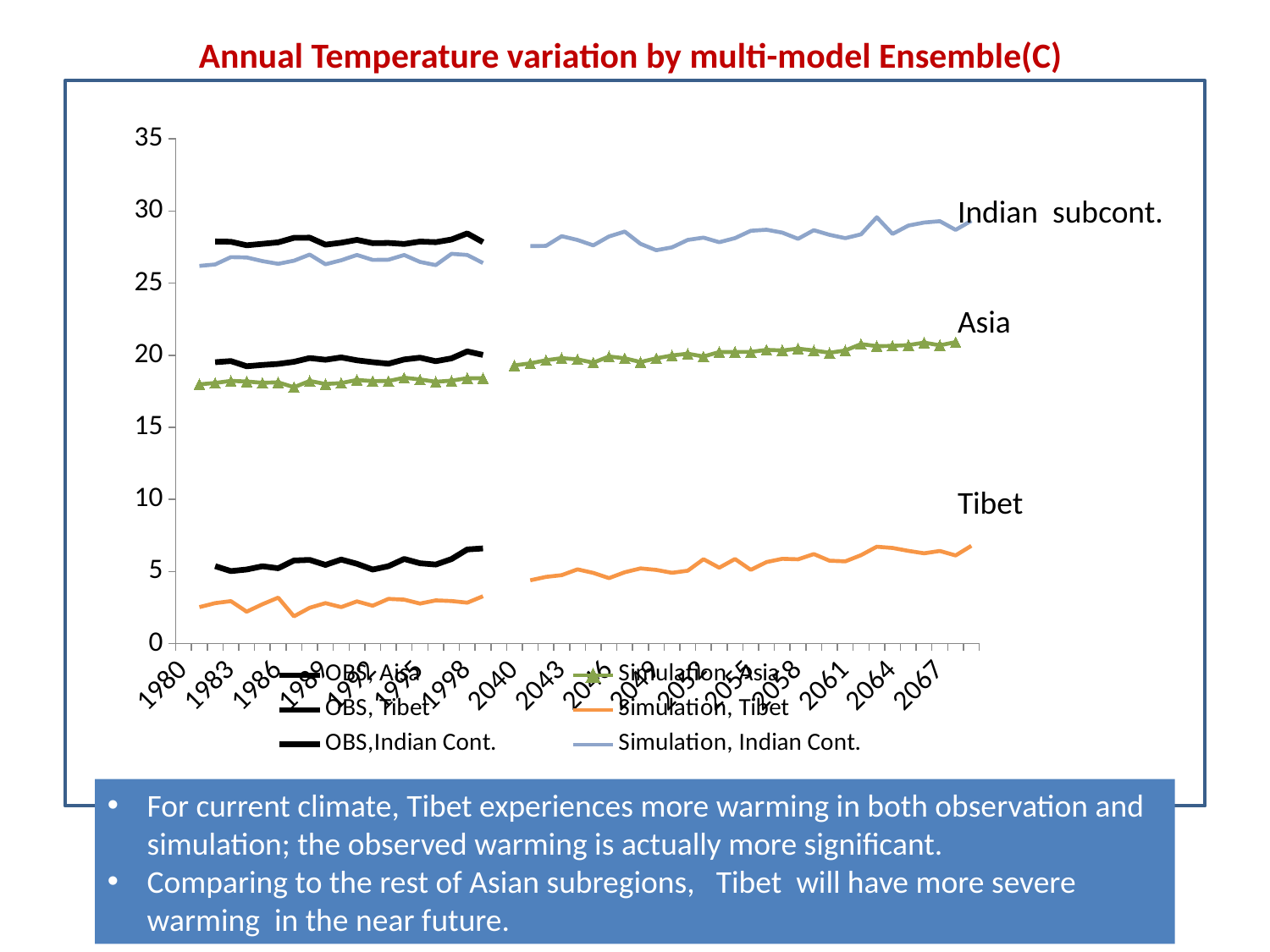
Is the value for Simulation, Indian Cont. in 2064 greater or less than 25? greater Does the Simulation, Asia line rise or fall from 2040 to 2067? rise Is the value for OBS,Indian Cont. in 1998 greater or less than 25? greater Which is larger in 2067, the value for Simulation, Asia or the value for Simulation, Tibet? Simulation, Asia Is the value for Simulation, Tibet in 2067 greater or less than 10? less How many series does the legend list? 6 Which region's lines are plotted lowest on the chart? Tibet What is the title of the chart? Annual Temperature variation by multi-model Ensemble(C) Which region's lines are plotted highest on the chart? Indian subcont. What colour is the Simulation, Tibet line? orange What kind of chart is shown on the slide? line chart